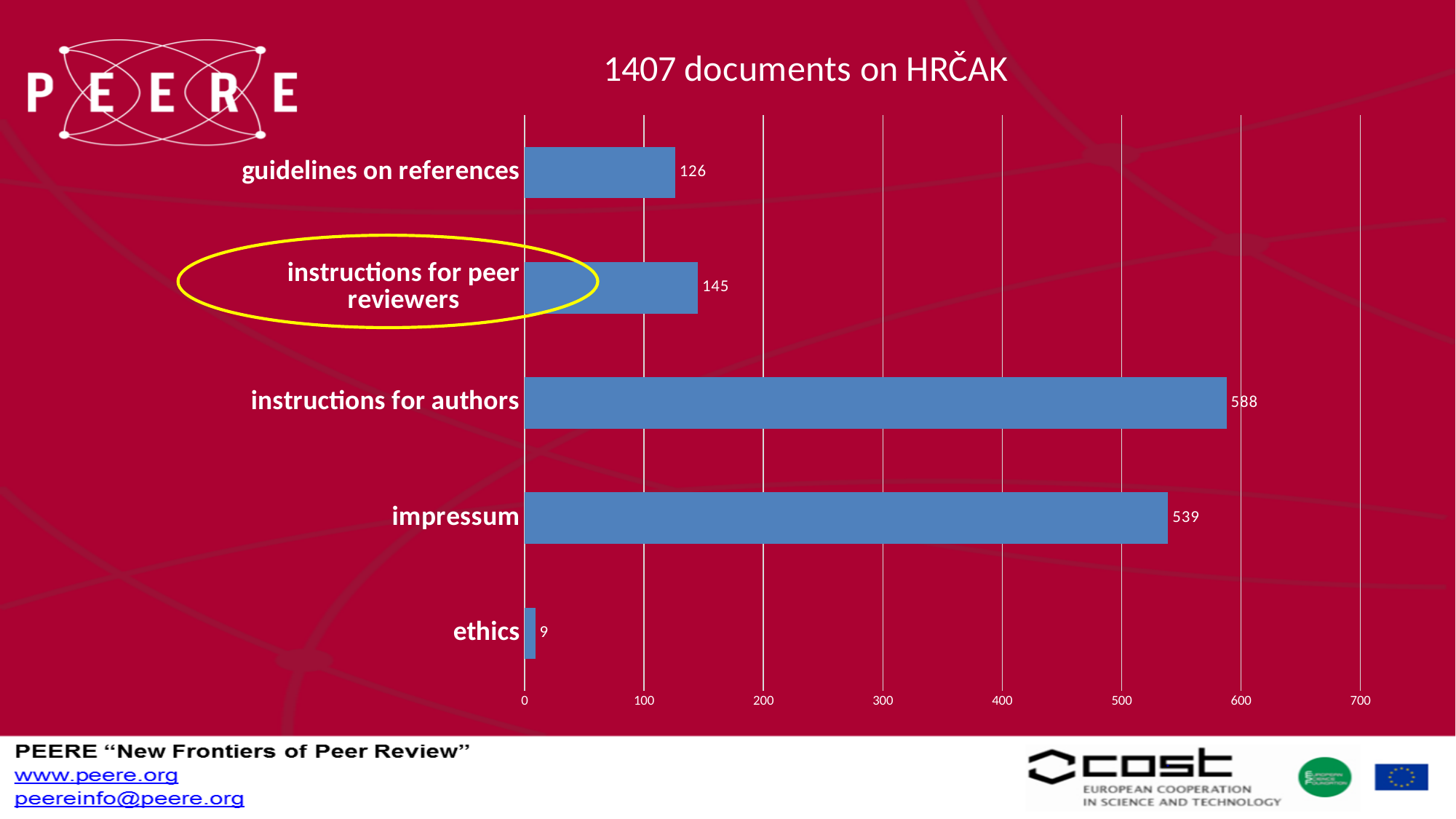
How many categories are shown in the chart? 5 Which category has the lowest value? ethics What is the difference between the values for instructions for authors and impressum? 49 What is the title of the chart? 1407 documents on HRČAK What kind of chart is shown on the slide? bar chart What is the value for instructions for authors? 588 What is the value for impressum? 539 Is the value for impressum greater or less than 500? greater What is the value for ethics? 9 Which category has the highest value? instructions for authors Which is larger, the value for instructions for peer reviewers or guidelines on references? instructions for peer reviewers What is the value for instructions for peer reviewers? 145